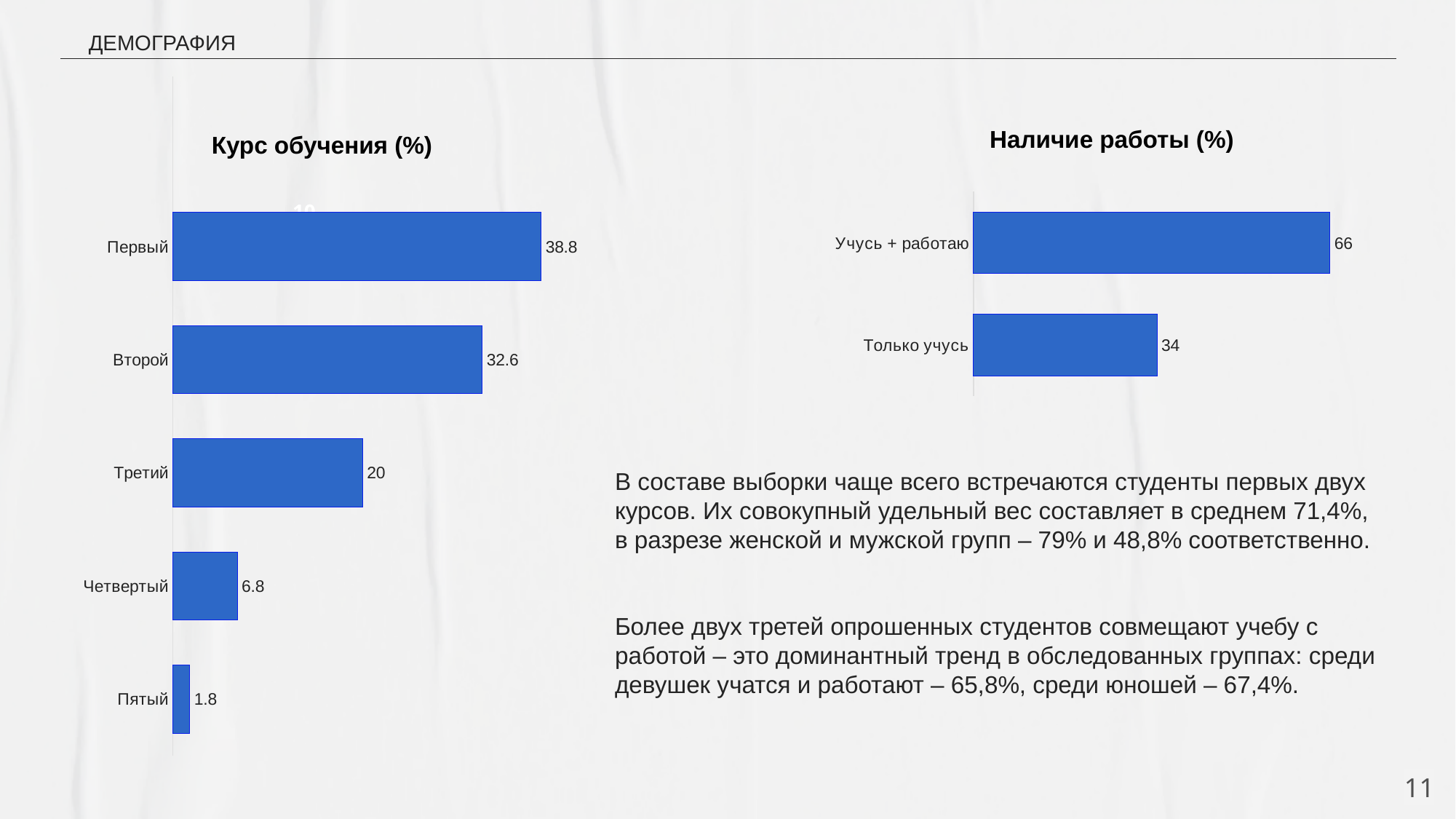
In the 'Курс обучения (%)' chart, which is larger, the value for Третий or the value for Четвертый? Третий In the 'Наличие работы (%)' chart, what is the value for Учусь + работаю? 66 How many categories are shown in the 'Наличие работы (%)' chart? 2 In the 'Наличие работы (%)' chart, what is the difference between the values for Учусь + работаю and Только учусь? 32 In the 'Курс обучения (%)' chart, what is the value for Пятый? 1.8 In the 'Курс обучения (%)' chart, what is the value for Первый? 38.8 In the 'Курс обучения (%)' chart, which category has the lowest value? Пятый In the 'Курс обучения (%)' chart, which category has the highest value? Первый What kind of chart is the 'Курс обучения (%)' chart? Bar chart In the 'Курс обучения (%)' chart, what is the value for Третий? 20 How many categories are shown in the 'Курс обучения (%)' chart? 5 In the 'Курс обучения (%)' chart, what is the difference between the values for Первый and Второй? 6.2